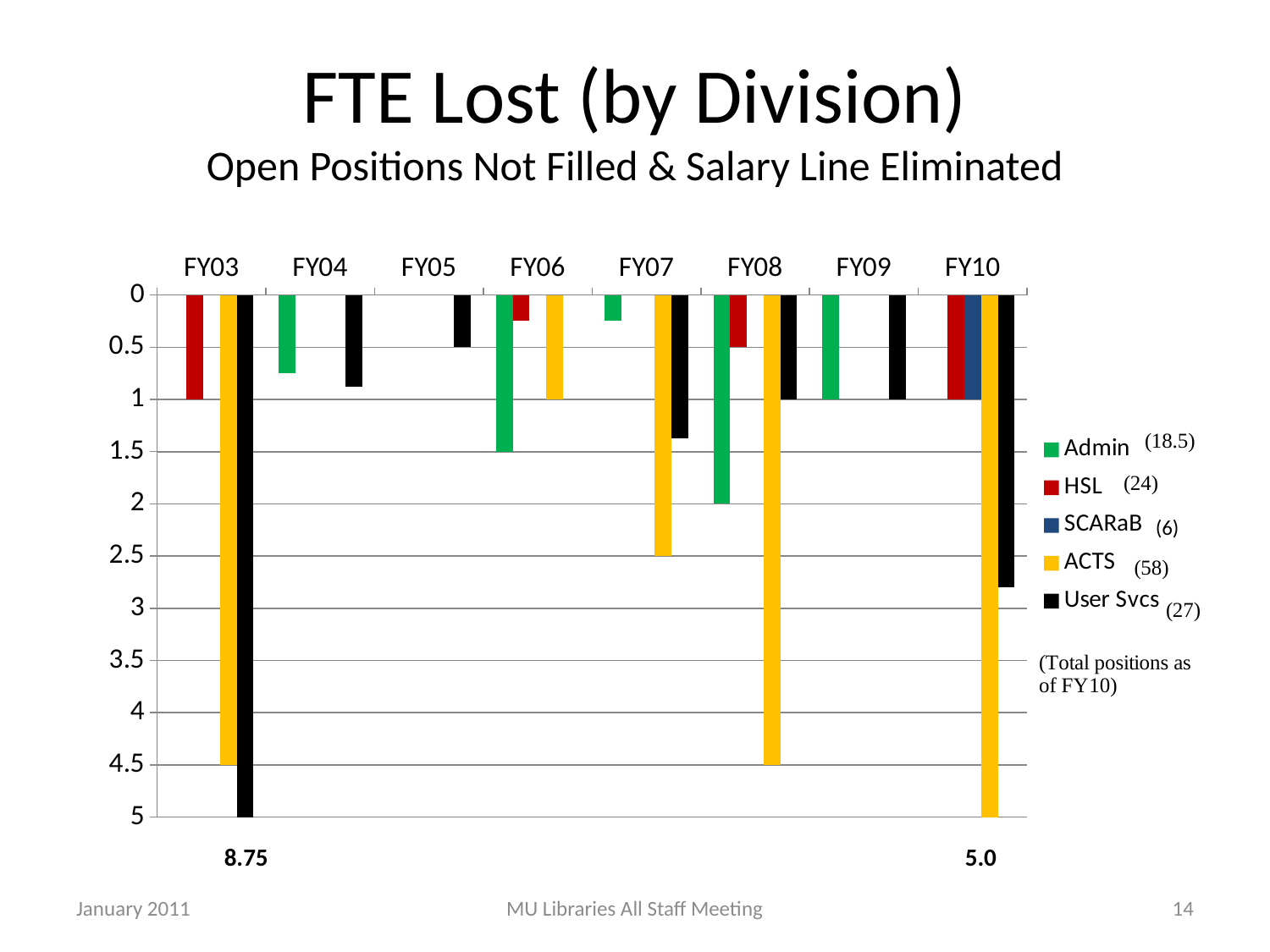
What is the FTE lost value for User Svcs in FY03? 8.75 Is the FTE lost value for User Svcs in FY10 greater or less than 2.5? greater What is the FTE lost value for Admin in FY08? 2 What is the FTE lost value for ACTS in FY03? 4.5 What is the difference between the FTE lost for ACTS and for Admin in FY08? 2.5 What kind of chart is shown on the slide? bar chart What is the FTE lost value for ACTS in FY07? 2.5 In FY08, which is larger: the FTE lost for ACTS or for Admin? ACTS How many series does the legend list? 5 How many fiscal years are shown along the x axis? 8 Which division has the largest FTE lost in FY03? User Svcs What is the FTE lost value for ACTS in FY10? 5